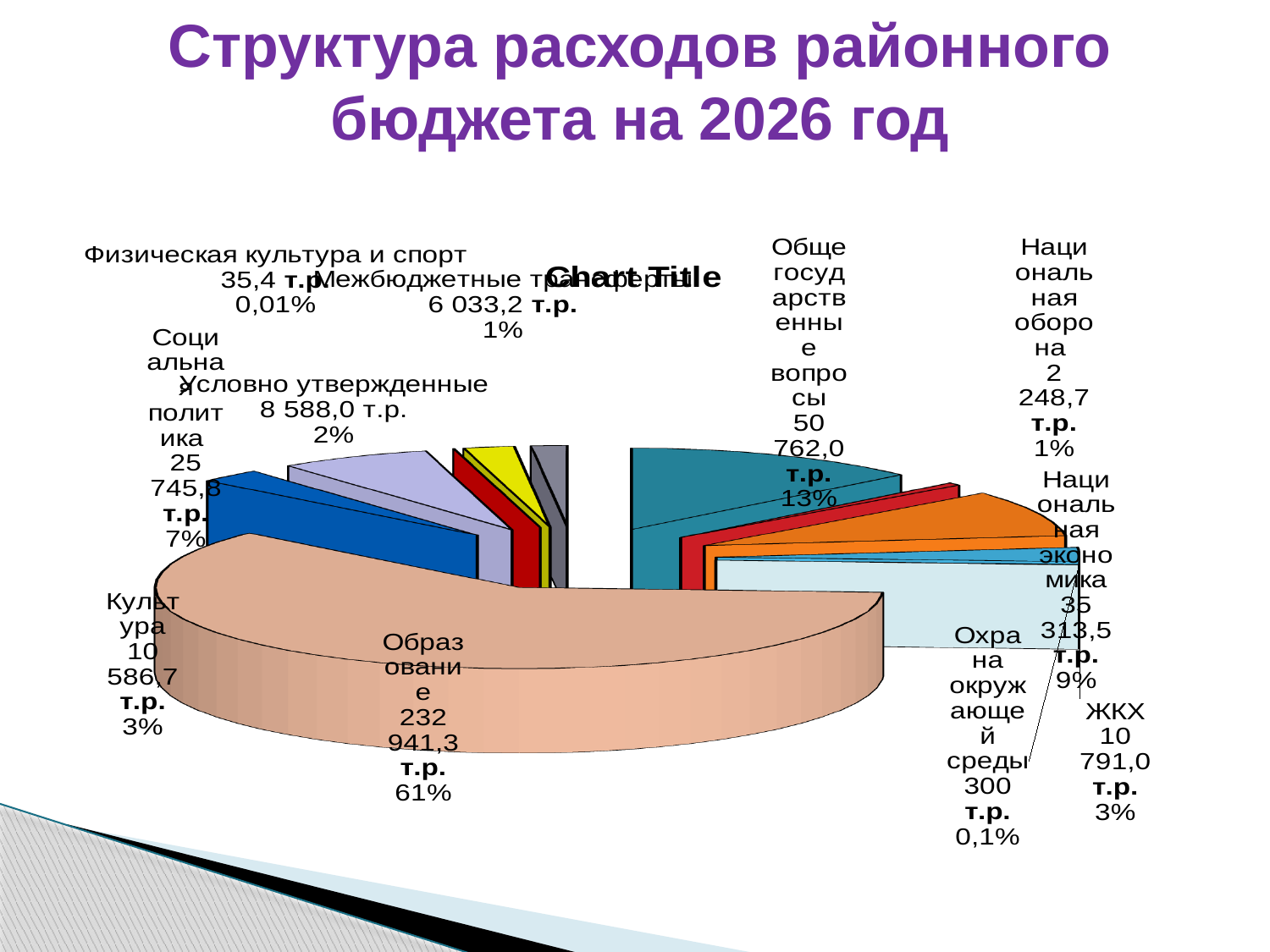
What is the difference between the values for ЖКХ and Культура? 204,3 т.р. What is the value for Образование? 232 941,3 т.р. What share of the pie does Условно утвержденные take? 2% What share of the pie does Социальная политика take? 7% Which is larger, the value for Культура or the value for ЖКХ? ЖКХ How many categories (slices) does the pie chart show? 11 Which category has the smallest share of the district budget expenditures? Физическая культура и спорт What share of the pie does Общегосударственные вопросы take? 13% What kind of chart is shown on the slide? pie chart What is the value for Охрана окружающей среды? 300 т.р. What is the value for Национальная экономика? 35 313,5 т.р. Which category has the largest share of the district budget expenditures? Образование